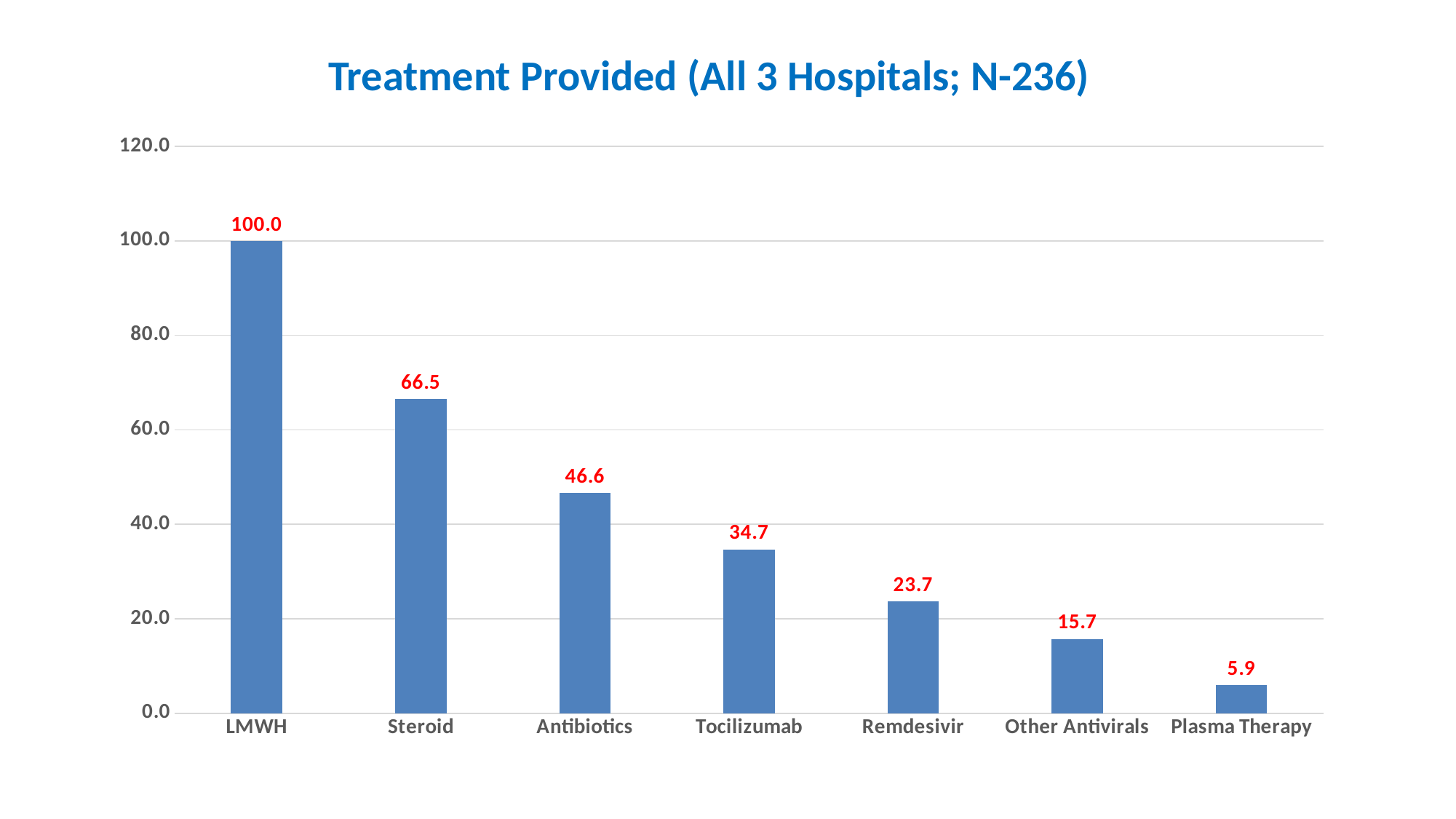
What is the value for Other Antivirals? 15.7 Is the value for Antibiotics greater or less than 40.0? greater What is the difference between the values for LMWH and Steroid? 33.5 Which treatment has the highest value? LMWH What is the value for Tocilizumab? 34.7 What is the difference between the values for Antibiotics and Remdesivir? 22.9 What kind of chart is shown on the slide? bar chart How many treatment categories are shown in the chart? 7 What is the value for Steroid? 66.5 Which treatment has the lowest value? Plasma Therapy What is the title of the chart? Treatment Provided (All 3 Hospitals; N-236) Which is larger, the value for Tocilizumab or the value for Remdesivir? Tocilizumab